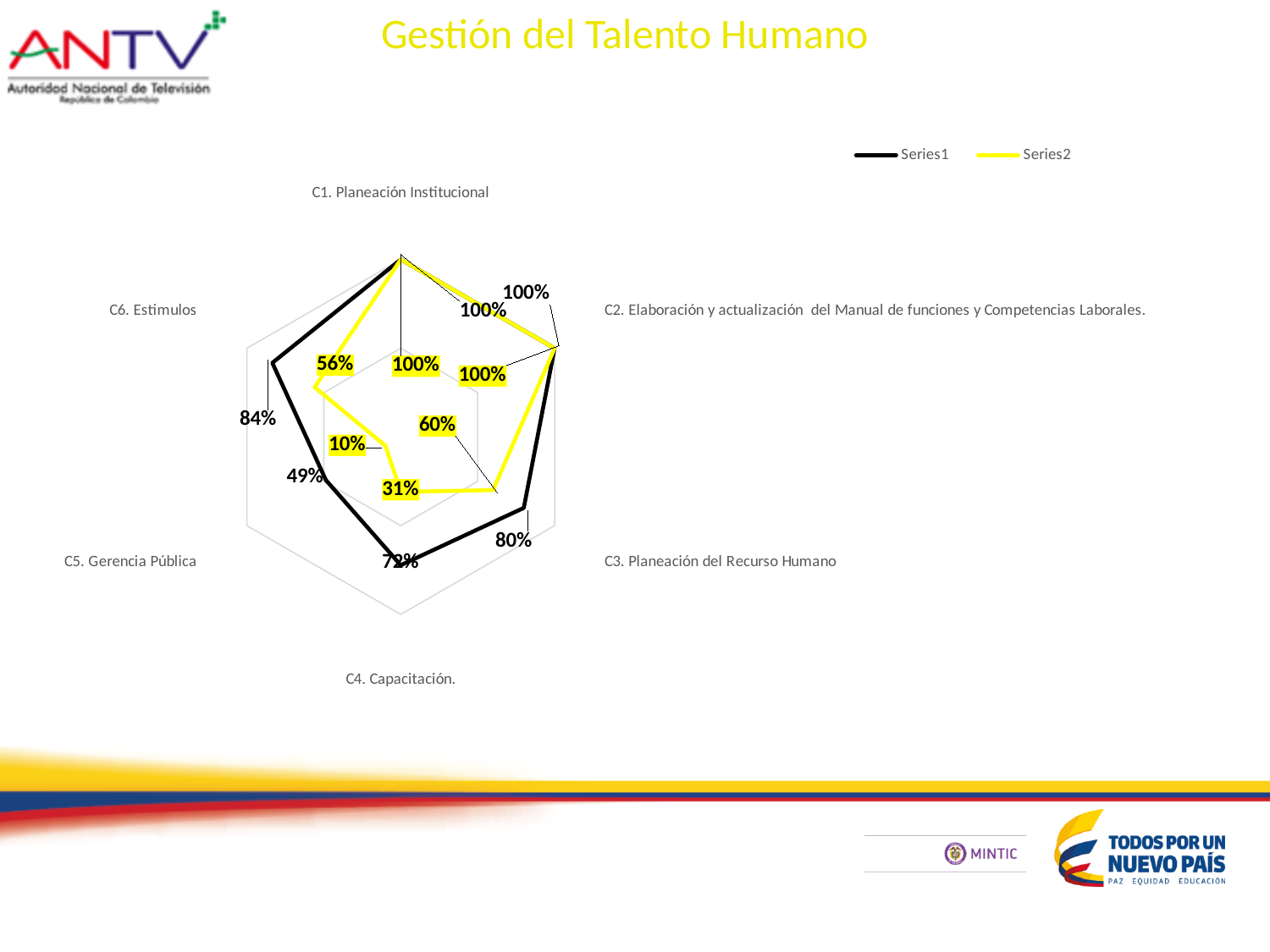
What is the difference between the Series1 and Series2 values for C3. Planeación del Recurso Humano? 20 percentage points How many categories (axes) does the radar chart have? 6 What is the Series1 value for C3. Planeación del Recurso Humano? 80% What is the Series2 value for C5. Gerencia Pública? 10% Which category has the lowest Series1 value? C5. Gerencia Pública What kind of chart is shown on the slide? Radar chart What is the Series1 value for C6. Estimulos? 84% Which category has the lowest Series2 value? C5. Gerencia Pública How many series does the chart legend list? 2 For C6. Estimulos, which series has the larger value, Series1 or Series2? Series1 What is the Series2 value for C4. Capacitación? 31% What is the Series2 value for C6. Estimulos? 56%